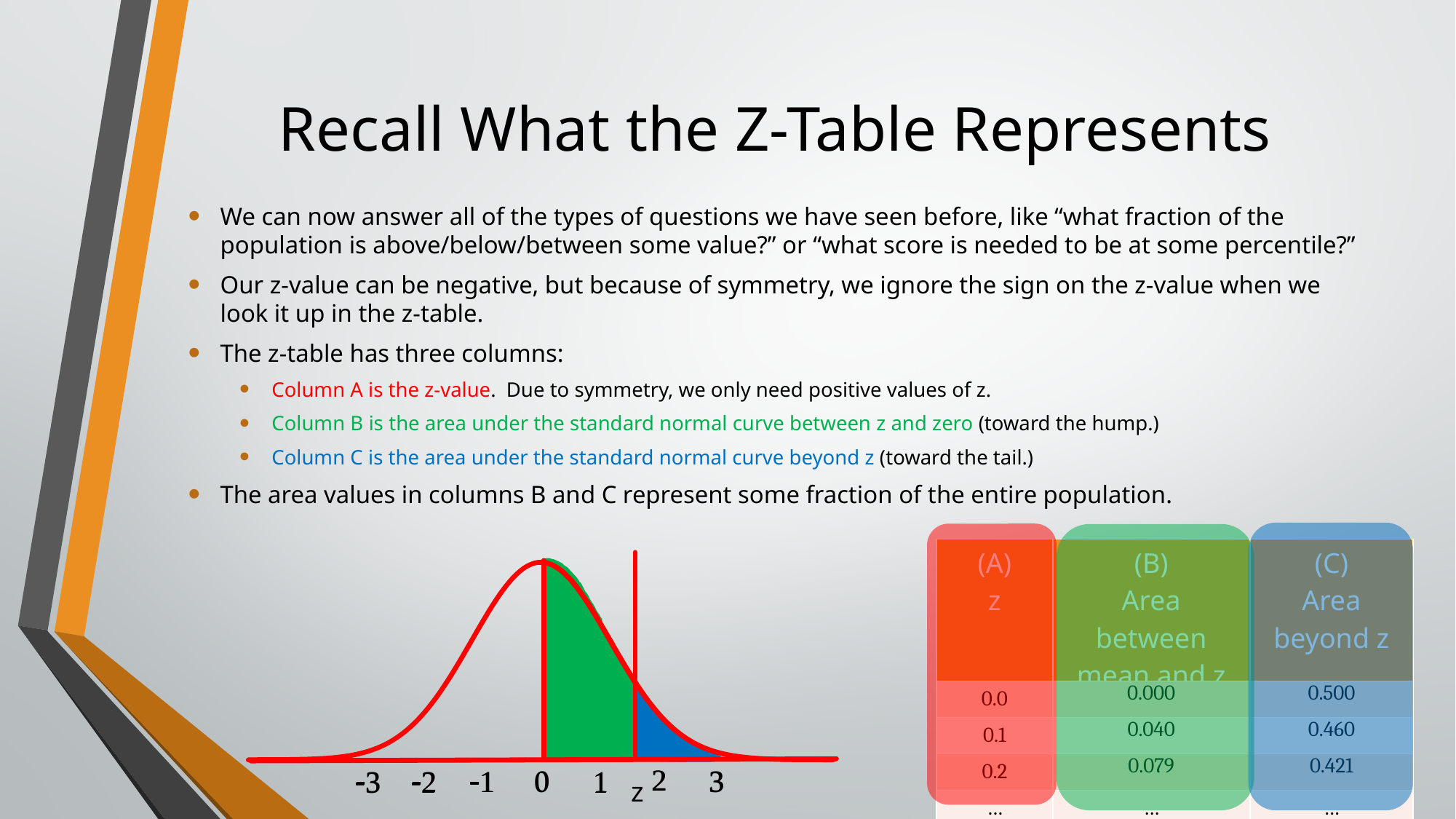
In the table, which is larger for z = 0.1: the area between mean and z, or the area beyond z? Area beyond z In the table, what is the difference between the area beyond z for z = 0.0 and for z = 0.2? 0.079 In the table, what is the area between mean and z for z = 0.2? 0.079 How many columns does the z-table on the slide have? 3 How many numbered tick labels are shown on the x axis of the normal curve chart? 7 In the table, what is the area beyond z for z = 0.0? 0.500 What colour is the shaded region between 0 and z on the normal curve chart? Green What are the lowest and highest tick labels on the x axis of the normal curve chart? -3 and 3 In the table, what is the area beyond z for z = 0.1? 0.460 In the table, what is the total of the area between mean and z and the area beyond z for z = 0.1? 0.500